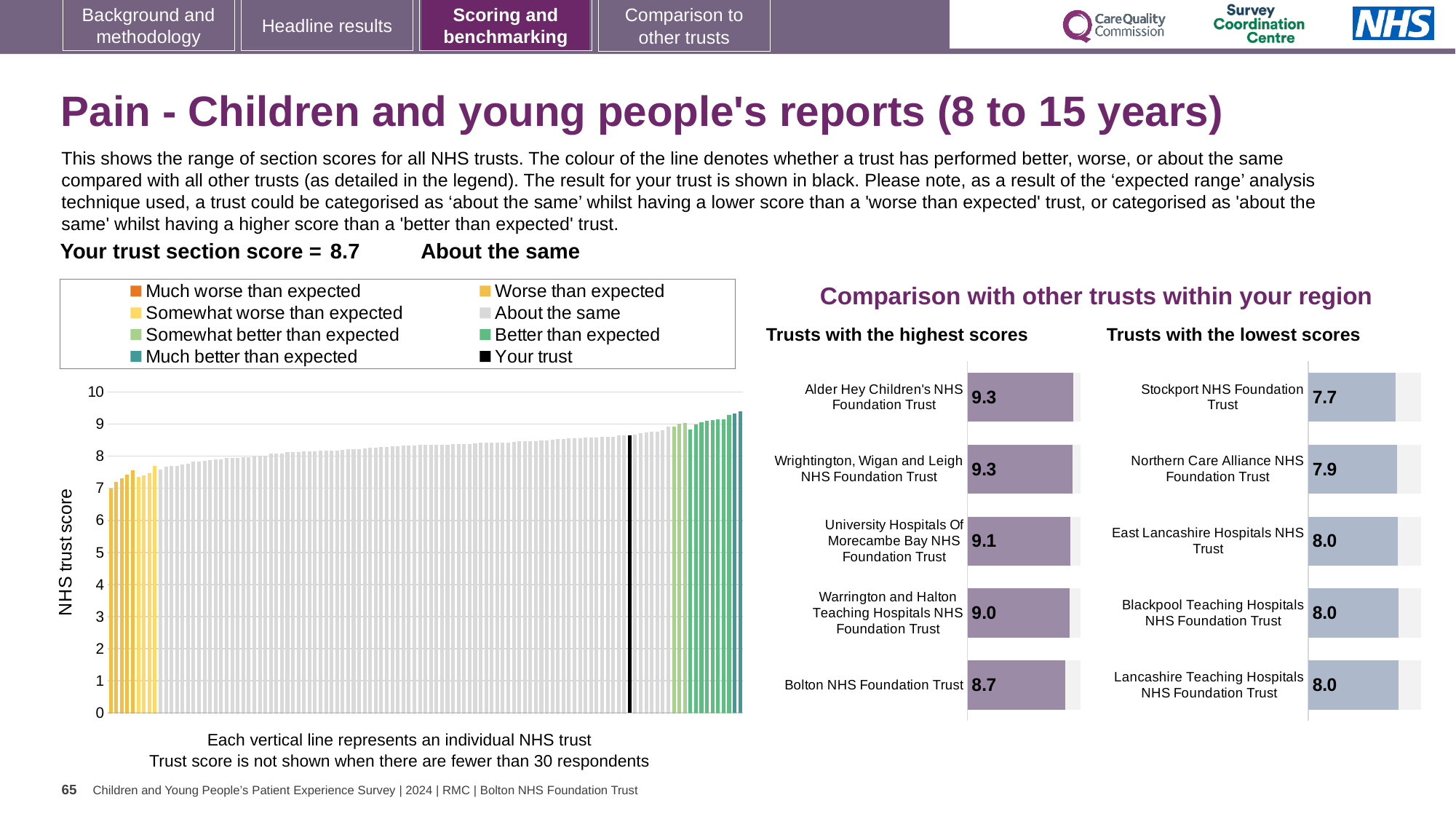
How many trusts are shown in the 'Trusts with the lowest scores' chart? 5 In the 'Trusts with the highest scores' chart, what is the score for Alder Hey Children's NHS Foundation Trust? 9.3 In the 'Trusts with the highest scores' chart, which has the higher score: University Hospitals Of Morecambe Bay NHS Foundation Trust or Warrington and Halton Teaching Hospitals NHS Foundation Trust? University Hospitals Of Morecambe Bay NHS Foundation Trust In the 'Trusts with the lowest scores' chart, which trust has the lowest score? Stockport NHS Foundation Trust In the 'Trusts with the highest scores' chart, what is the score for Bolton NHS Foundation Trust? 8.7 In the 'Trusts with the lowest scores' chart, what is the difference between the scores of Northern Care Alliance NHS Foundation Trust and Stockport NHS Foundation Trust? 0.2 How many entries does the legend above the large chart on the left list? 8 In the large chart on the left, do the trust scores rise or fall from left to right? Rise In the 'Trusts with the lowest scores' chart, what is the score for Stockport NHS Foundation Trust? 7.7 What type of chart is the large chart on the left with the y-axis labelled 'NHS trust score'? Bar chart In the 'Trusts with the highest scores' chart, what is the difference between the scores of Alder Hey Children's NHS Foundation Trust and Bolton NHS Foundation Trust? 0.6 In the large chart on the left, is the value of the black bar (your trust) greater or less than 8? greater